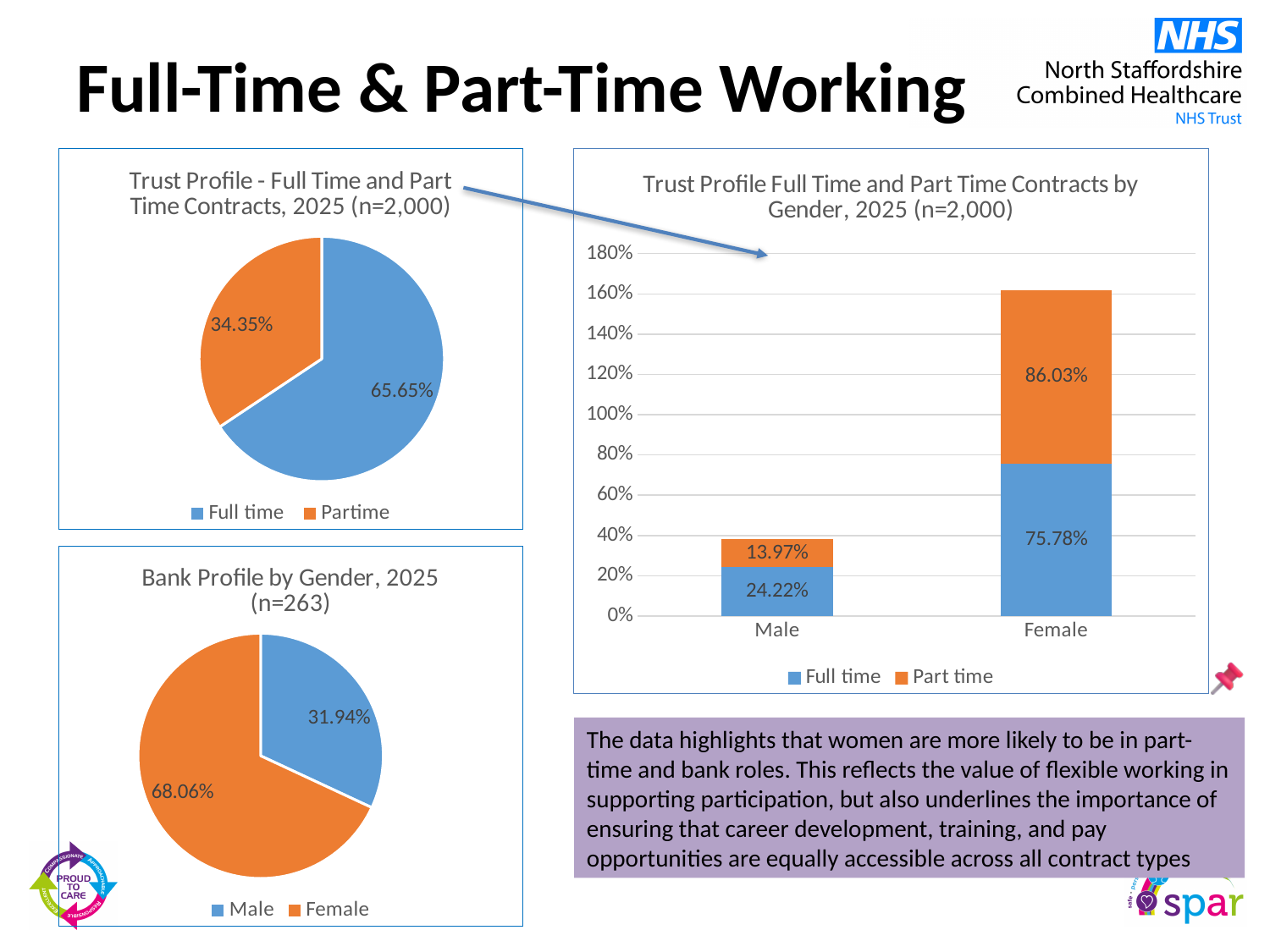
How many series does the legend of the 'Trust Profile Full Time and Part Time Contracts by Gender, 2025' chart list? 2 In the 'Trust Profile Full Time and Part Time Contracts by Gender, 2025' chart, what is the difference between the Female and Male Full time values? 51.56% In the 'Trust Profile Full Time and Part Time Contracts by Gender, 2025' chart, what is the total of the stacked bar for Male? 38.19% In the 'Bank Profile by Gender, 2025' pie chart, what percentage is Female? 68.06% In the 'Bank Profile by Gender, 2025' pie chart, what percentage is Male? 31.94% In the 'Trust Profile Full Time and Part Time Contracts by Gender, 2025' chart, what is the Full time value for Male? 24.22% In the 'Trust Profile - Full Time and Part Time Contracts, 2025' pie chart, what percentage is Partime? 34.35% In the 'Trust Profile - Full Time and Part Time Contracts, 2025' pie chart, which slice is larger, Full time or Partime? Full time What kind of chart is the 'Trust Profile Full Time and Part Time Contracts by Gender, 2025' chart? Stacked bar chart In the 'Trust Profile - Full Time and Part Time Contracts, 2025' pie chart, what percentage is Full time? 65.65% In the 'Bank Profile by Gender, 2025' pie chart, what is the difference between the Female and Male shares? 36.12% In the 'Trust Profile Full Time and Part Time Contracts by Gender, 2025' chart, what is the Part time value for Female? 86.03%